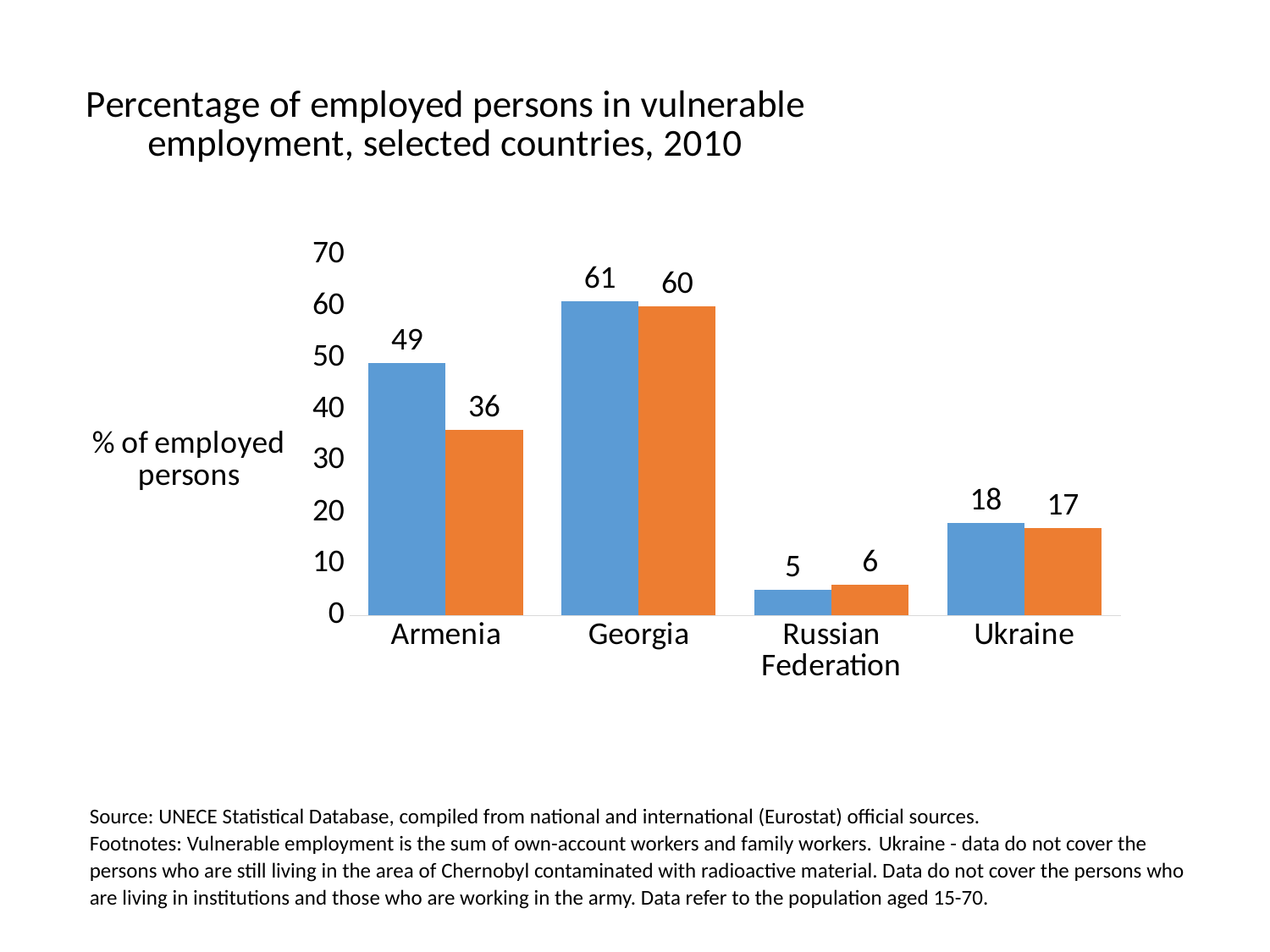
What is the label on the vertical axis? % of employed persons What is the value of the orange bar for the Russian Federation? 6 What is the value of the orange bar for Georgia? 60 Which country has the highest blue bar? Georgia Is the blue bar for Georgia greater or less than 50? greater Which country has the lowest orange bar? Russian Federation What is the difference between the blue and orange bars for Armenia? 13 Which is larger for Ukraine, the blue bar or the orange bar? the blue bar What is the title of the chart? Percentage of employed persons in vulnerable employment, selected countries, 2010 What kind of chart is shown on the slide? bar chart How many countries are shown on the x axis? 4 What is the value of the blue bar for Armenia? 49